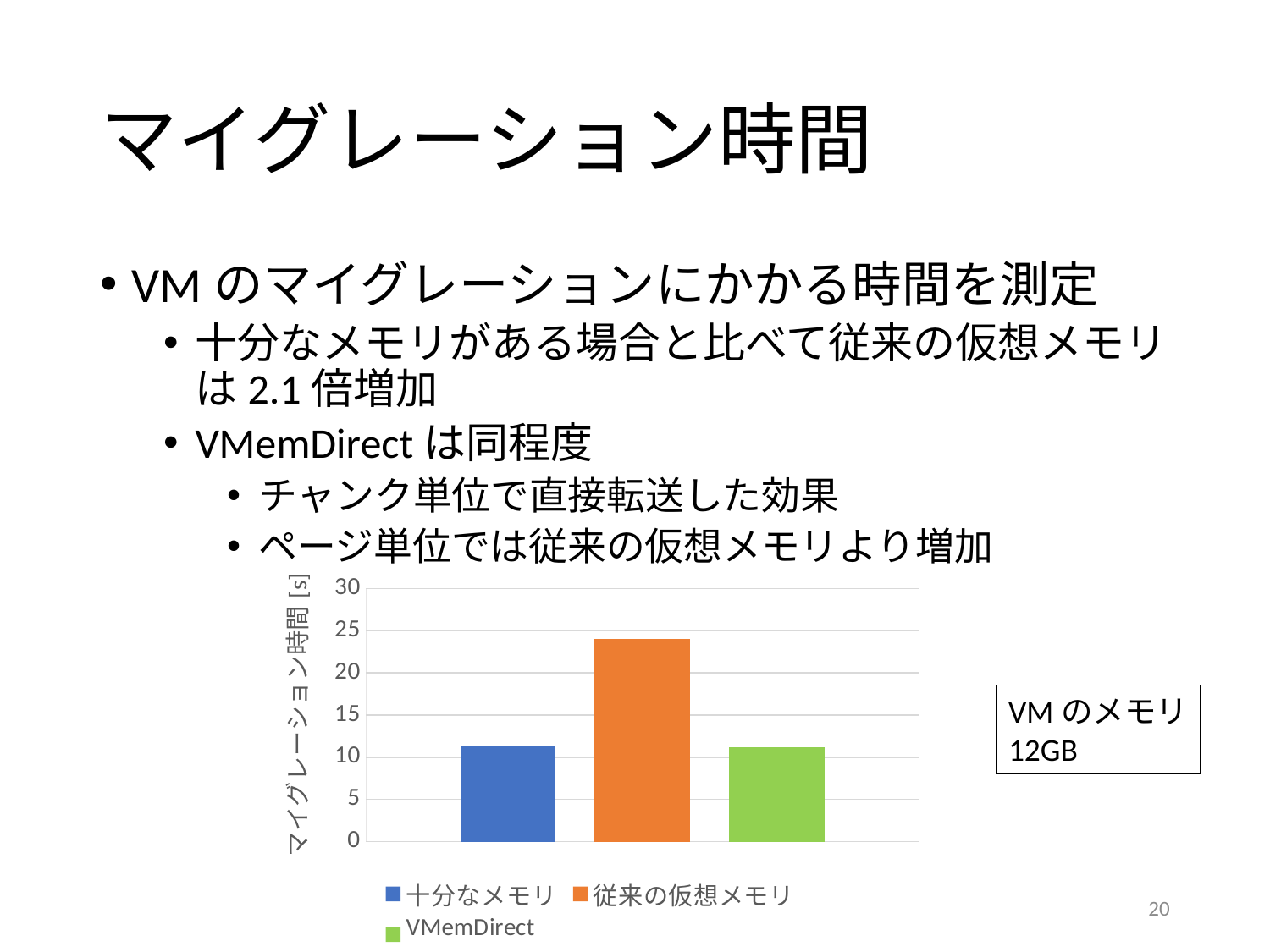
How many series does the chart legend list? 3 What is the label of the vertical axis of the chart? マイグレーション時間 [s] Is the value for 十分なメモリ greater or less than 15? less Is the value for 従来の仮想メモリ greater or less than 25? less How many bars are plotted in the chart? 3 Which is larger, the value for 十分なメモリ or the value for 従来の仮想メモリ? 従来の仮想メモリ Is the value for 従来の仮想メモリ greater or less than 20? greater What kind of chart is shown on the slide? bar chart What colour is the bar for VMemDirect in the chart? green Which series has the highest migration time in the chart? 従来の仮想メモリ Which is larger, the value for 従来の仮想メモリ or the value for VMemDirect? 従来の仮想メモリ